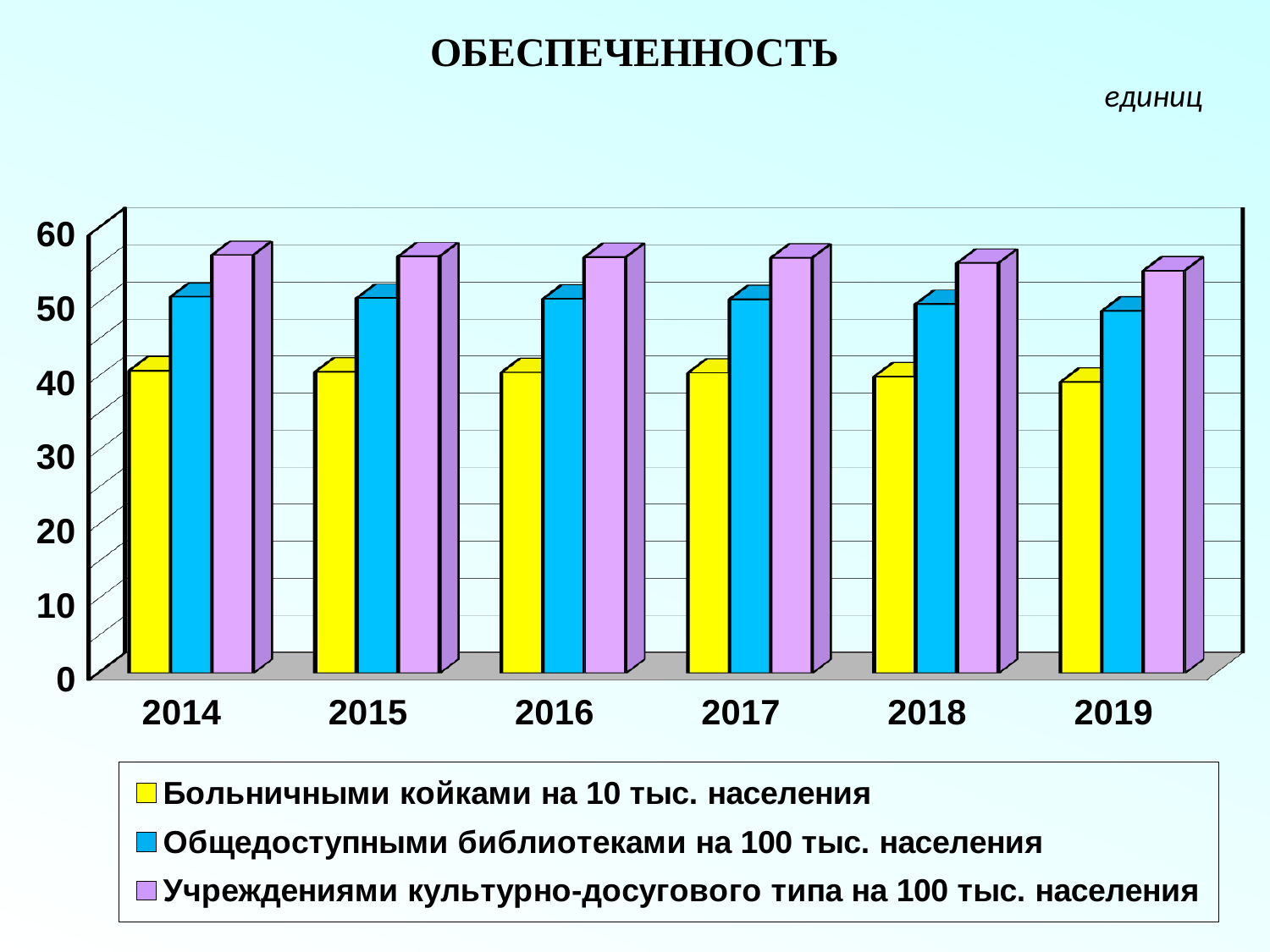
Is the value for Учреждениями культурно-досугового типа на 100 тыс. населения in 2019 greater or less than 60? less How many years are shown on the x axis of the chart? 6 How many series does the legend list? 3 In 2016, which is larger: the value for Общедоступными библиотеками на 100 тыс. населения or the value for Больничными койками на 10 тыс. населения? Общедоступными библиотеками на 100 тыс. населения Is the value for Общедоступными библиотеками на 100 тыс. населения in 2018 greater or less than 40? greater Which series has the lowest value in 2019? Больничными койками на 10 тыс. населения What kind of chart is shown on the slide? bar chart Is the value for Больничными койками на 10 тыс. населения in 2015 greater or less than 50? less Which series is shown in yellow in the legend? Больничными койками на 10 тыс. населения What is the title of the chart? ОБЕСПЕЧЕННОСТЬ Which series has the highest value in 2014? Учреждениями культурно-досугового типа на 100 тыс. населения